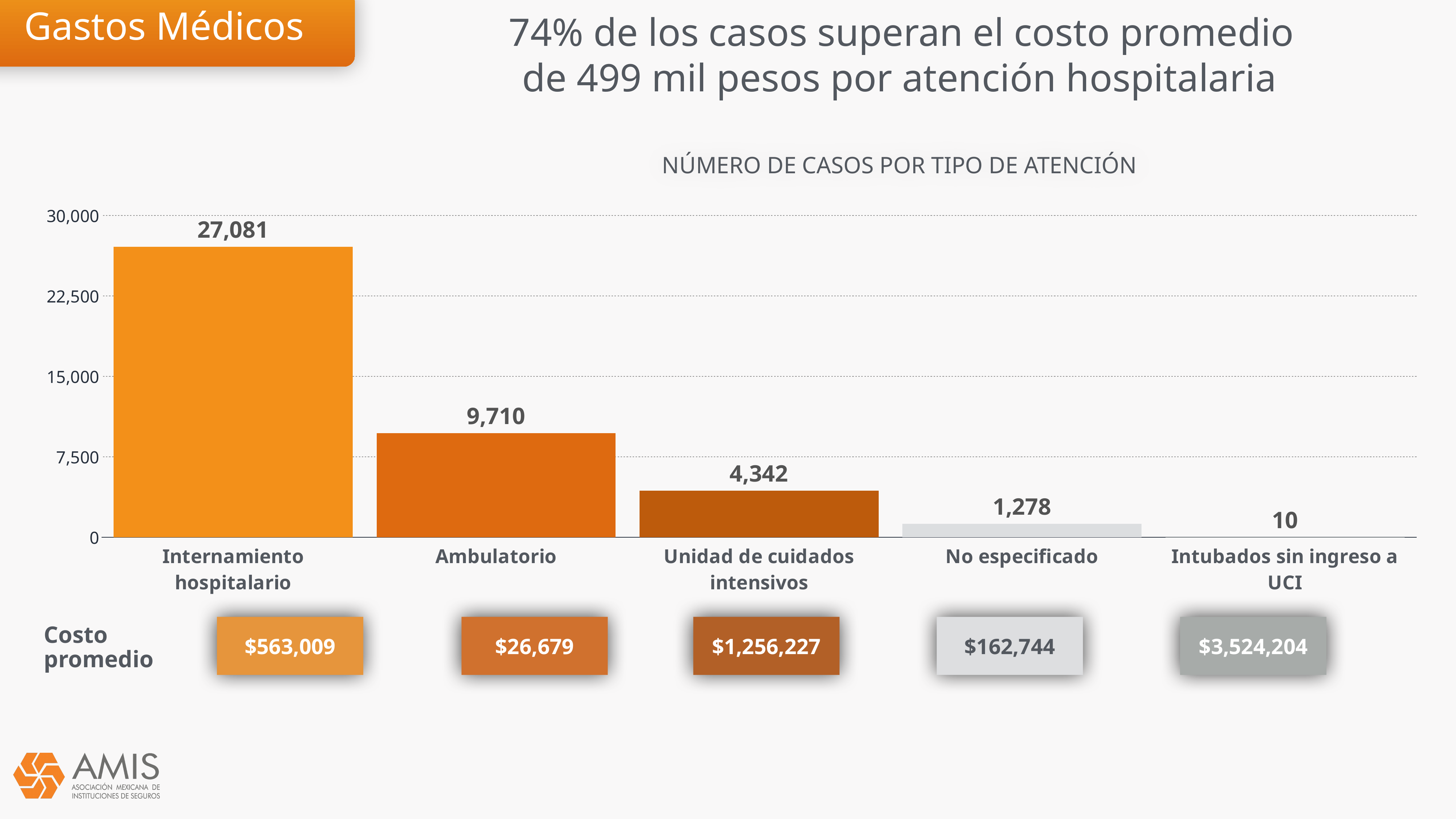
What is the difference in number of cases between Unidad de cuidados intensivos and No especificado? 3,064 Which type of attention has the highest number of cases? Internamiento hospitalario What is the number of cases for Unidad de cuidados intensivos? 4,342 Which has more cases, Ambulatorio or Unidad de cuidados intensivos? Ambulatorio What is the number of cases for Internamiento hospitalario? 27,081 What is the difference in number of cases between Internamiento hospitalario and Ambulatorio? 17,371 What is the number of cases for Intubados sin ingreso a UCI? 10 Which type of attention has the lowest number of cases? Intubados sin ingreso a UCI What kind of chart is shown on the slide? Bar chart What is the number of cases for Ambulatorio? 9,710 How many types of attention are shown in the chart? 5 What is the title of the chart? NÚMERO DE CASOS POR TIPO DE ATENCIÓN